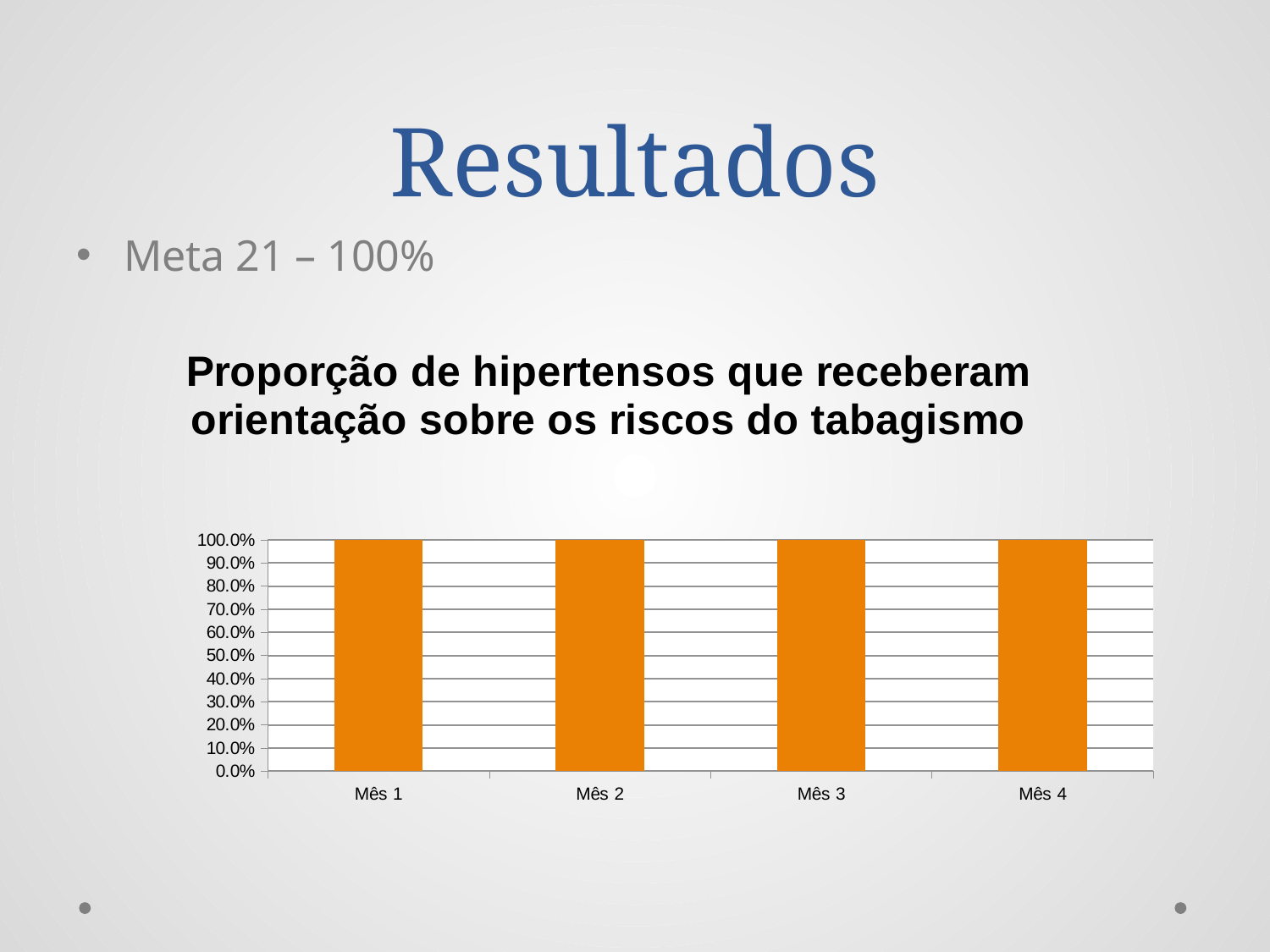
What kind of chart is shown on the slide? bar chart What is the title of the chart? Proporção de hipertensos que receberam orientação sobre os riscos do tabagismo What colour are the bars in the chart? orange What is the value for Mês 4? 100.0% How many categories (months) are plotted on the x axis? 4 Is the value for Mês 4 greater or less than 90.0%? greater Is the value for Mês 2 greater or less than 50.0%? greater Do the values rise, fall or stay the same from Mês 1 to Mês 4? stay the same What is the difference between the values for Mês 1 and Mês 4? 0.0% What is the highest value shown on the y axis? 100.0% What is the value for Mês 3? 100.0% What is the value for Mês 1? 100.0%